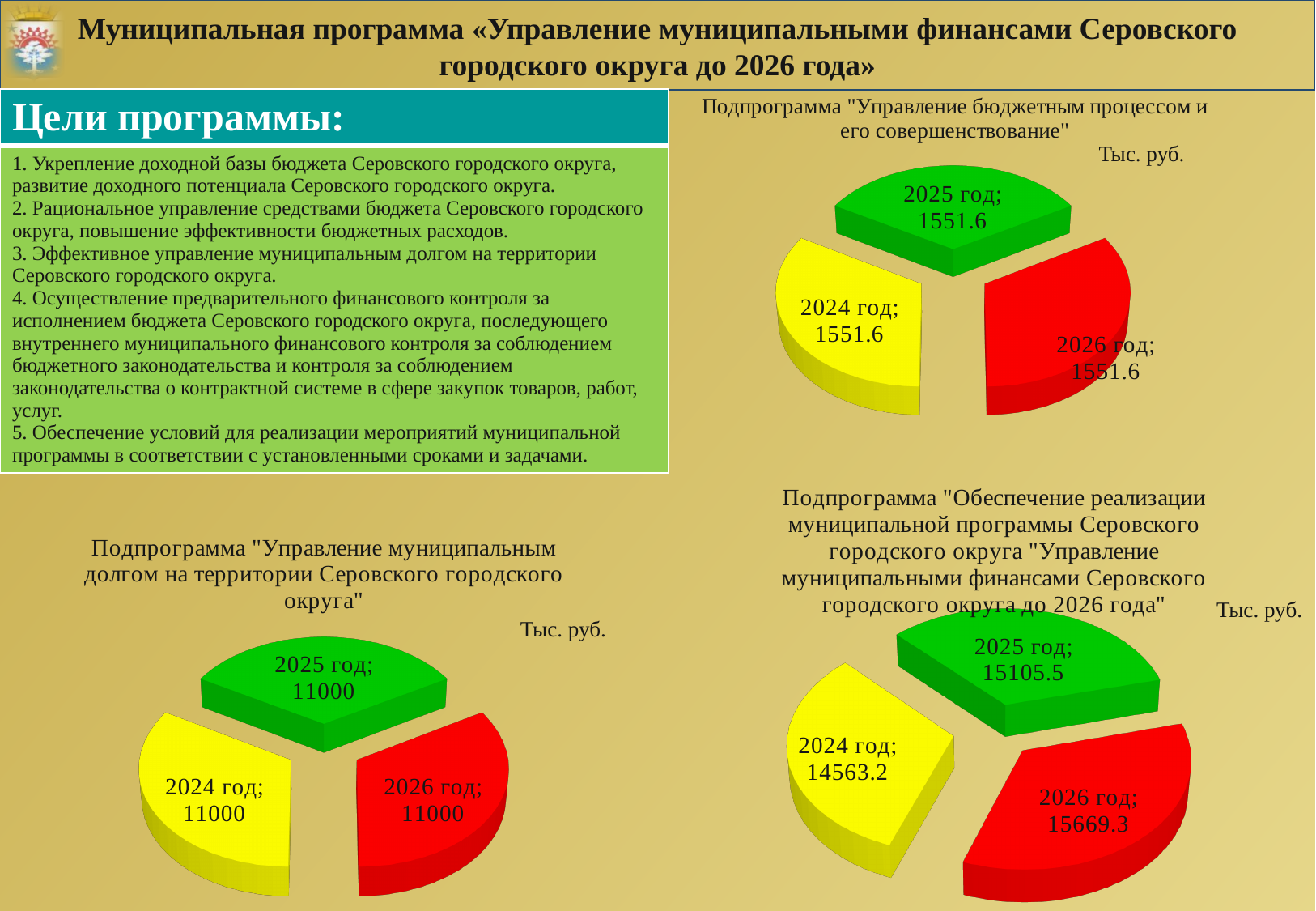
In the pie chart titled "Подпрограмма "Управление муниципальным долгом на территории Серовского городского округа"", what is the total of all three slices? 33000 In the pie chart titled "Подпрограмма "Управление муниципальным долгом на территории Серовского городского округа"", what is the value for 2026 год? 11000 How many slices does the pie chart titled "Подпрограмма "Управление муниципальным долгом на территории Серовского городского округа"" have? 3 In the bottom-right pie chart ("Подпрограмма "Обеспечение реализации муниципальной программы...""), do the values rise or fall from 2024 год to 2026 год? rise In the pie chart titled "Подпрограмма "Управление бюджетным процессом и его совершенствование"", what is the value for 2025 год? 1551.6 What unit is indicated next to the pie chart titled "Подпрограмма "Управление бюджетным процессом и его совершенствование""? Тыс. руб. In the bottom-right pie chart ("Подпрограмма "Обеспечение реализации муниципальной программы...""), what is the difference between the values for 2026 год and 2024 год? 1106.1 What type of chart is used for "Подпрограмма "Управление бюджетным процессом и его совершенствование""? pie chart In the bottom-right pie chart ("Подпрограмма "Обеспечение реализации муниципальной программы...""), which is larger: the value for 2025 год or 2024 год? 2025 год In the bottom-right pie chart ("Подпрограмма "Обеспечение реализации муниципальной программы...""), which year has the lowest value? 2024 год In the bottom-right pie chart ("Подпрограмма "Обеспечение реализации муниципальной программы...""), which year has the highest value? 2026 год In the bottom-right pie chart ("Подпрограмма "Обеспечение реализации муниципальной программы...""), what is the value for 2024 год? 14563.2